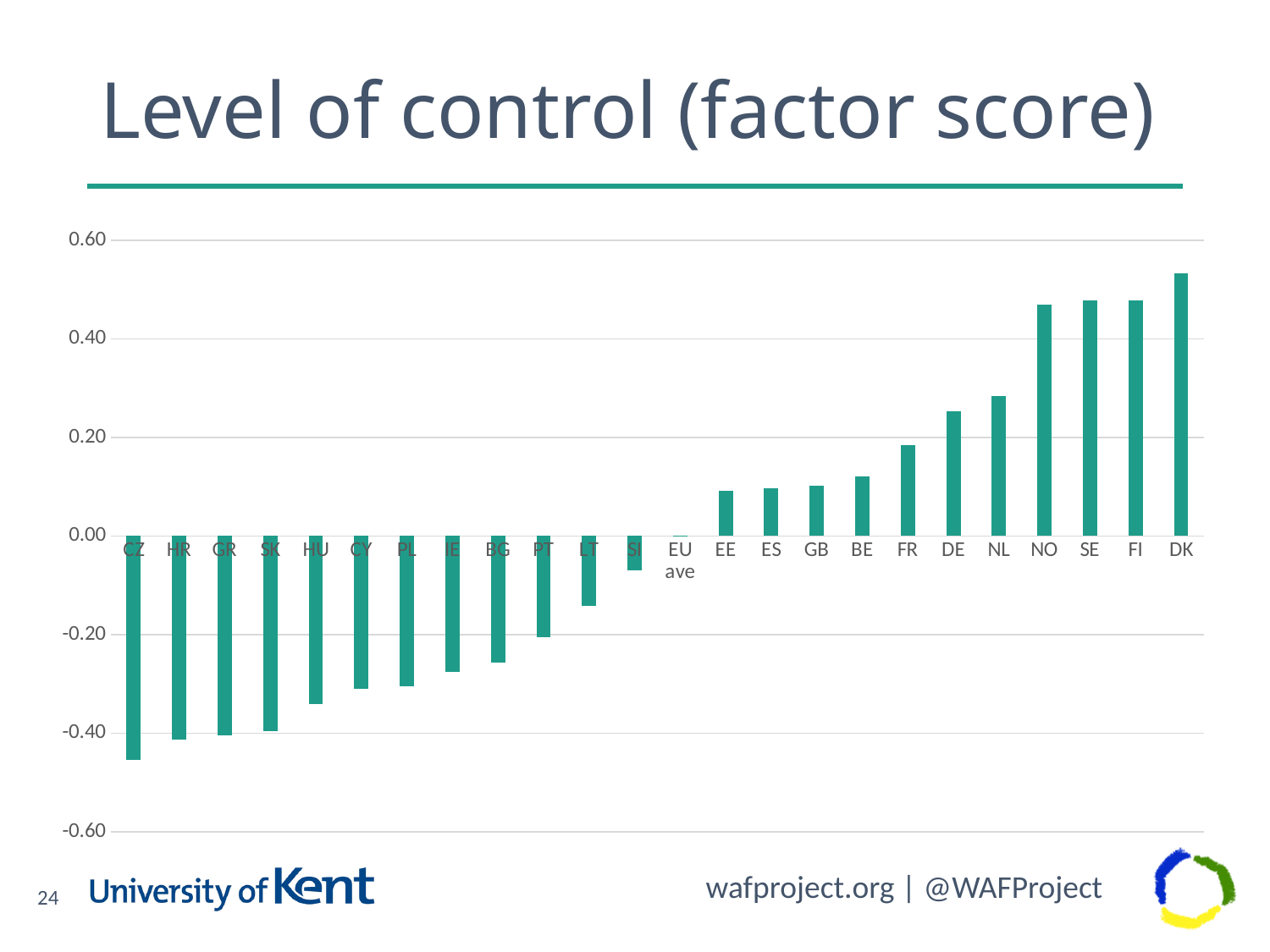
Is the value for NL greater or less than 0.20? greater What kind of chart is shown on the slide? bar chart Do the values rise or fall moving from left to right along the x axis? rise Is the value for HU greater or less than -0.20? less Is the value for DK greater or less than 0.40? greater Which is larger, the value for DK or the value for NO? DK Which category has the lowest value? CZ Which category has the highest value? DK What is the title of the chart? Level of control (factor score) How many categories are plotted on the x axis? 24 Which is larger, the value for SI or the value for CZ? SI